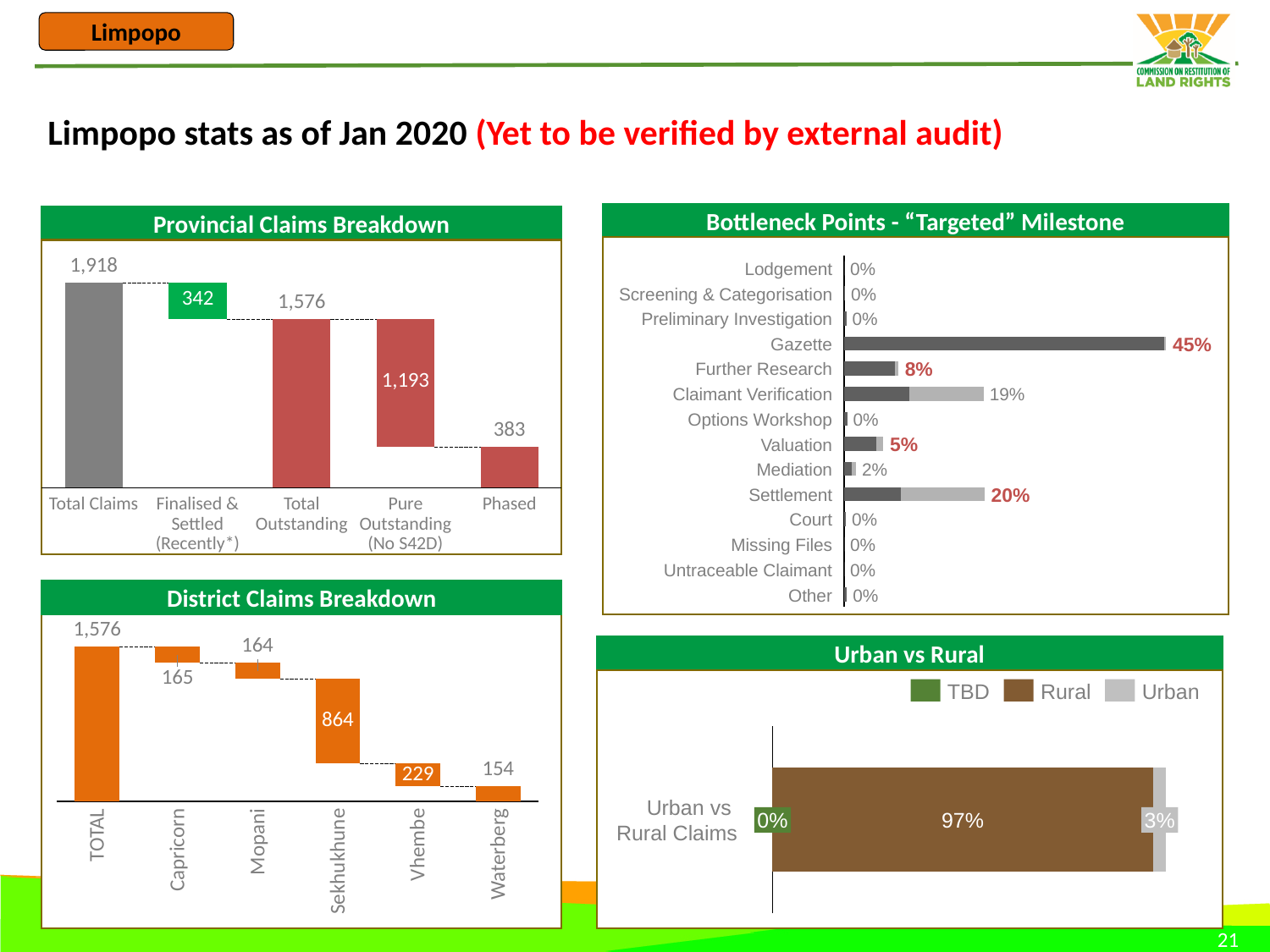
In the District Claims Breakdown chart, what is the value for Sekhukhune? 864 In the District Claims Breakdown chart, which district (excluding TOTAL) has the highest value? Sekhukhune In the Bottleneck Points chart, what is the value for Gazette? 45% In the Provincial Claims Breakdown chart, what is the difference between Total Claims and Total Outstanding? 342 How many categories are listed in the Bottleneck Points chart? 14 In the District Claims Breakdown chart, which district has the lowest value? Waterberg In the Provincial Claims Breakdown chart, what is the value for Total Claims? 1,918 In the Urban vs Rural chart, what is the value for Rural? 97% In the Provincial Claims Breakdown chart, what is the value for Pure Outstanding (No S42D)? 1,193 In the Bottleneck Points chart, which category has the highest value? Gazette In the District Claims Breakdown chart, what is the difference between Vhembe and Waterberg? 75 What kind of chart is the Bottleneck Points chart? Bar chart